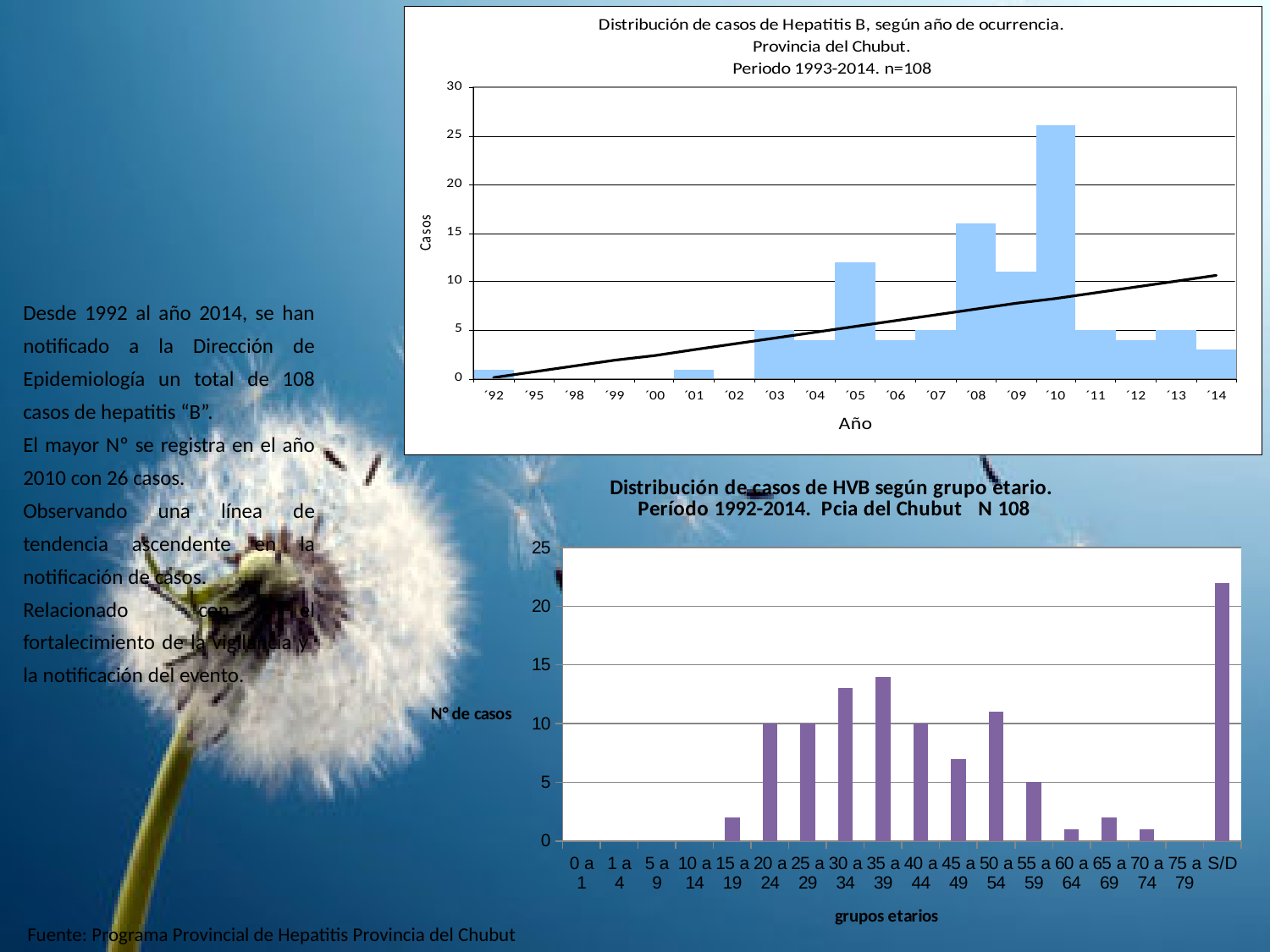
What kind of chart is the top chart, 'Distribución de casos de Hepatitis B, según año de ocurrencia'? Bar chart In the bottom chart (cases by age group), which age group has the highest number of cases? S/D In the bottom chart (cases by age group), what is the number of cases for the 55 a 59 group? 5 In the top chart (cases by year), is the value for ´10 greater or less than 25? greater In the top chart (cases by year), does the black trend line rise or fall from left to right? Rises In the bottom chart (cases by age group), is the value for 35 a 39 greater or less than 10? greater In the top chart (cases by year), is the value for ´08 greater or less than 15? greater What is the title of the top chart? Distribución de casos de Hepatitis B, según año de ocurrencia. Provincia del Chubut. Periodo 1993-2014. n=108 What kind of chart is the bottom chart, 'Distribución de casos de HVB según grupo etario'? Bar chart In the top chart (cases by year), which year has the highest number of cases? ´10 In the top chart (cases by year), which has more cases, ´08 or ´05? ´08 In the bottom chart (cases by age group), what is the number of cases for the 20 a 24 group? 10